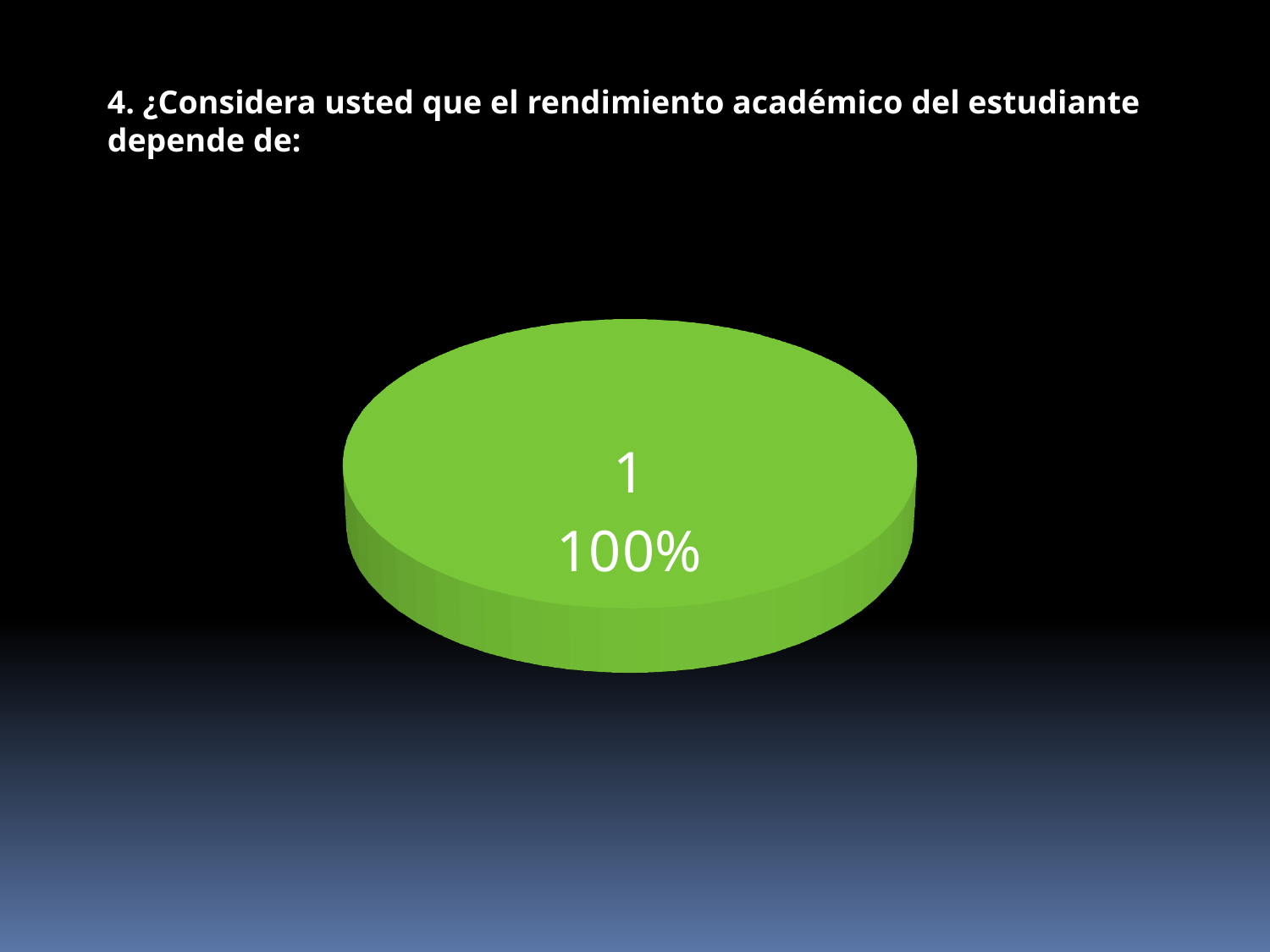
How many slices does the pie chart have? 1 What is the text of the heading above the pie chart? 4. ¿Considera usted que el rendimiento académico del estudiante depende de: What colour is the slice of the pie chart? green What kind of chart is shown on the slide? pie chart What percentage share is printed on the pie chart's slice? 100% What value is printed on the pie chart's slice above the percentage? 1